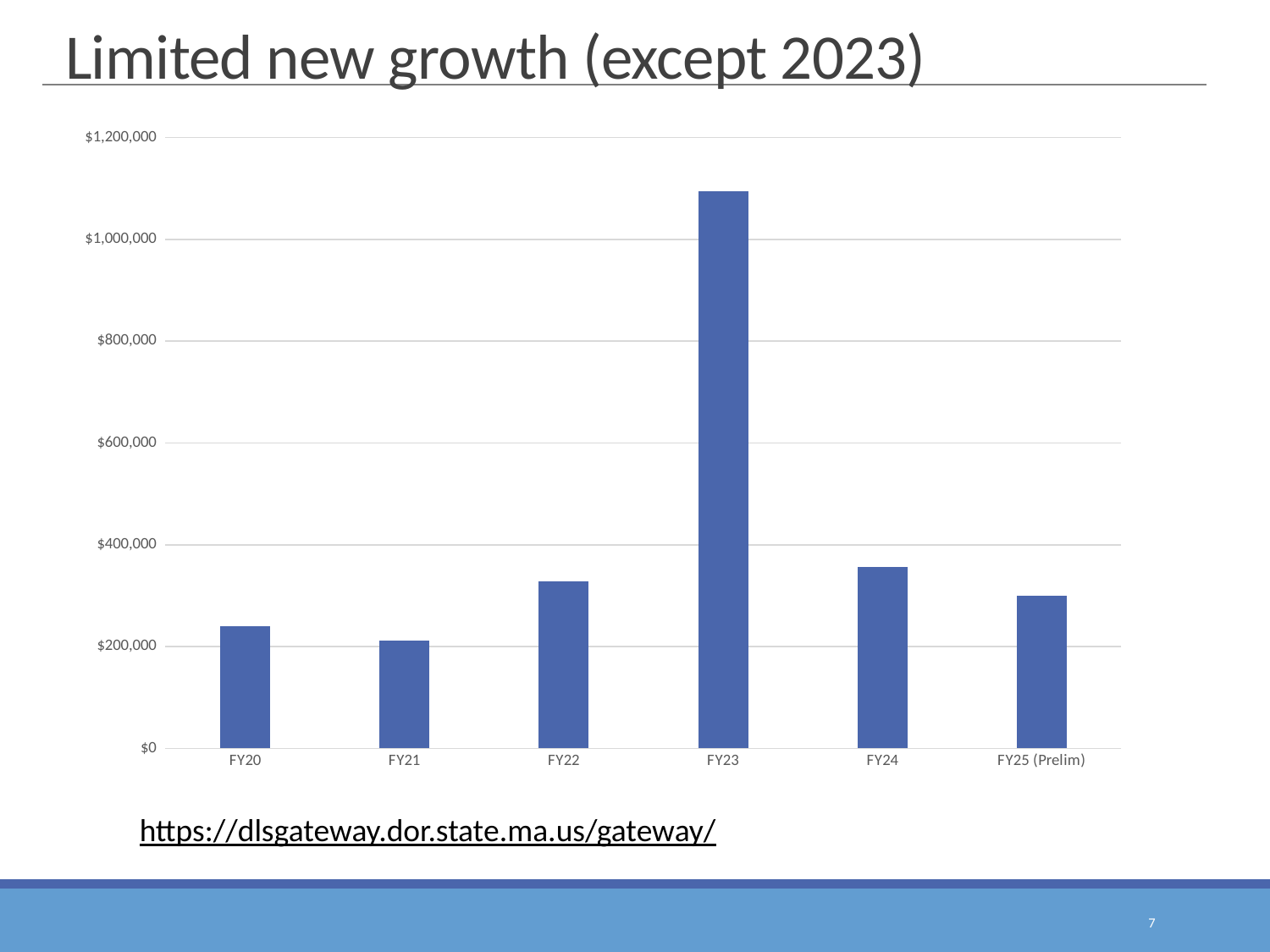
Is the value for FY22 greater or less than $400,000? less Which fiscal year has the lowest value? FY21 What is the title of the slide containing the chart? Limited new growth (except 2023) Which fiscal year has the highest value? FY23 Is the value for FY24 greater or less than $400,000? less Which is larger, the value for FY20 or the value for FY22? FY22 Which is larger, the value for FY23 or the value for FY24? FY23 Is the value for FY25 (Prelim) greater or less than $200,000? greater What kind of chart is shown on the slide? Bar chart How many fiscal years are plotted on the x axis? 6